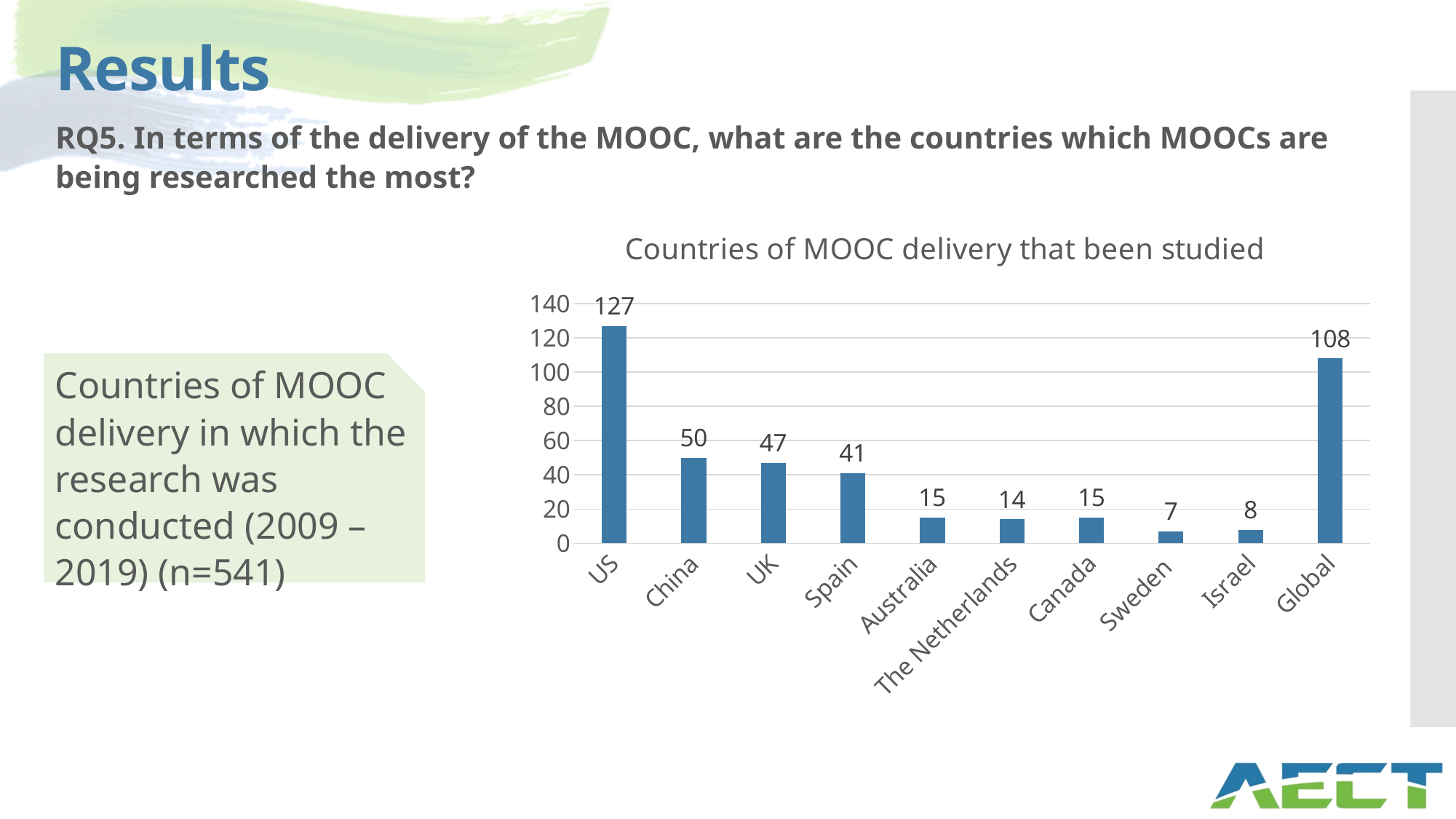
What is the difference between the values for the US and Global? 19 What kind of chart is shown on the slide? bar chart What is the value for Global? 108 Is the value for Global greater or less than 100? greater Which is larger, the value for Spain or the value for Canada? Spain Which category has the highest value? US How many categories are shown on the x axis? 10 Which category has the lowest value? Sweden What is the title of the chart? Countries of MOOC delivery that been studied What is the value for The Netherlands? 14 What is the value for the US? 127 What is the difference between the values for China and the UK? 3